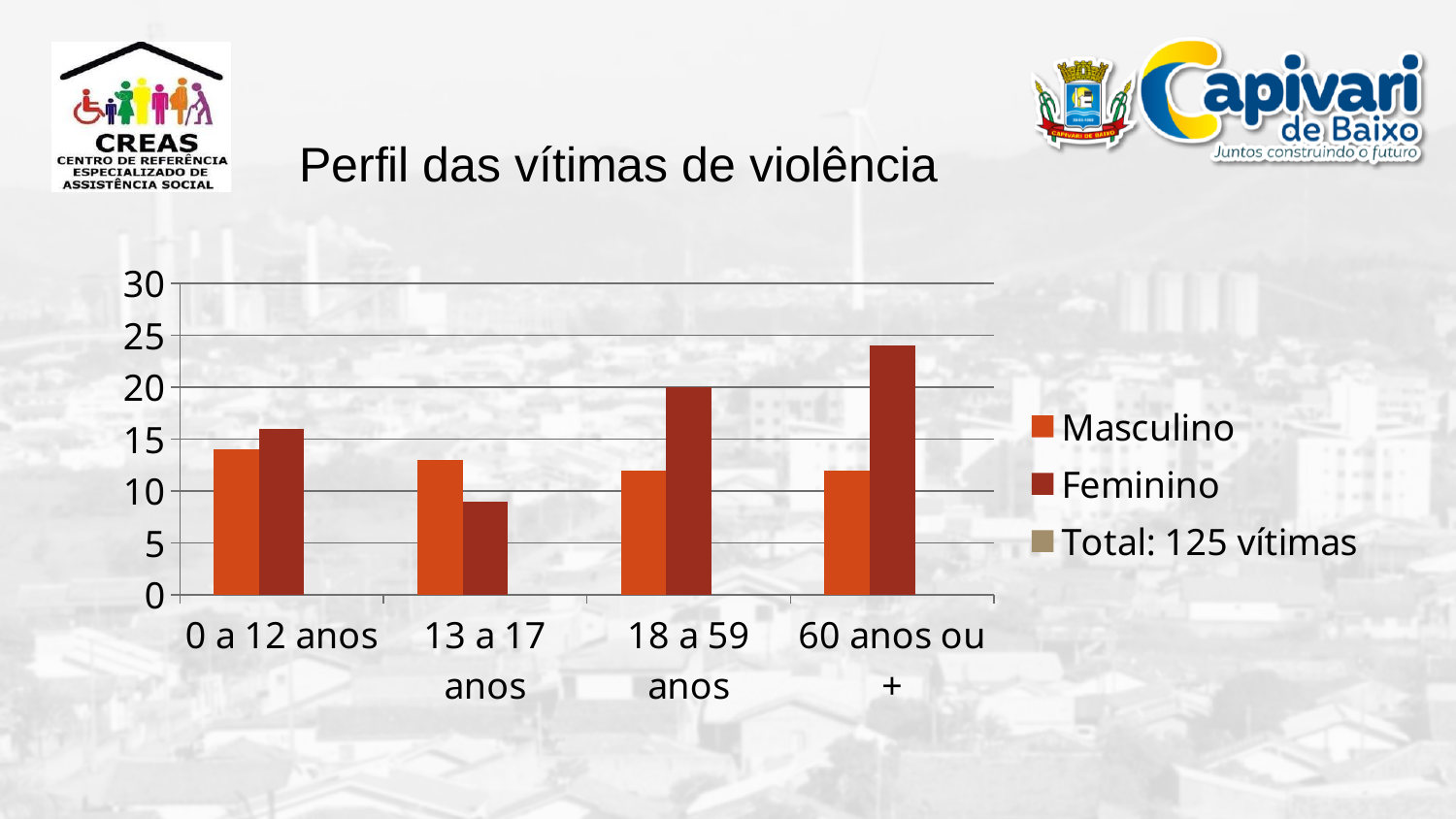
What kind of chart is shown on the slide? bar chart For which age category is the Feminino value lowest? 13 a 17 anos How many entries does the legend list? 3 Is the Masculino value for 18 a 59 anos greater or less than 10? greater In the 13 a 17 anos category, which is larger, Masculino or Feminino? Masculino Is the Feminino value for 13 a 17 anos greater or less than 10? less For which age category is the Feminino value highest? 60 anos ou + According to the legend, what is the total number of victims? 125 vítimas Is the Feminino value for 60 anos ou + greater or less than 20? greater What is the title of the chart? Perfil das vítimas de violência How many age categories are shown on the x axis? 4 In the 60 anos ou + category, which is larger, Masculino or Feminino? Feminino